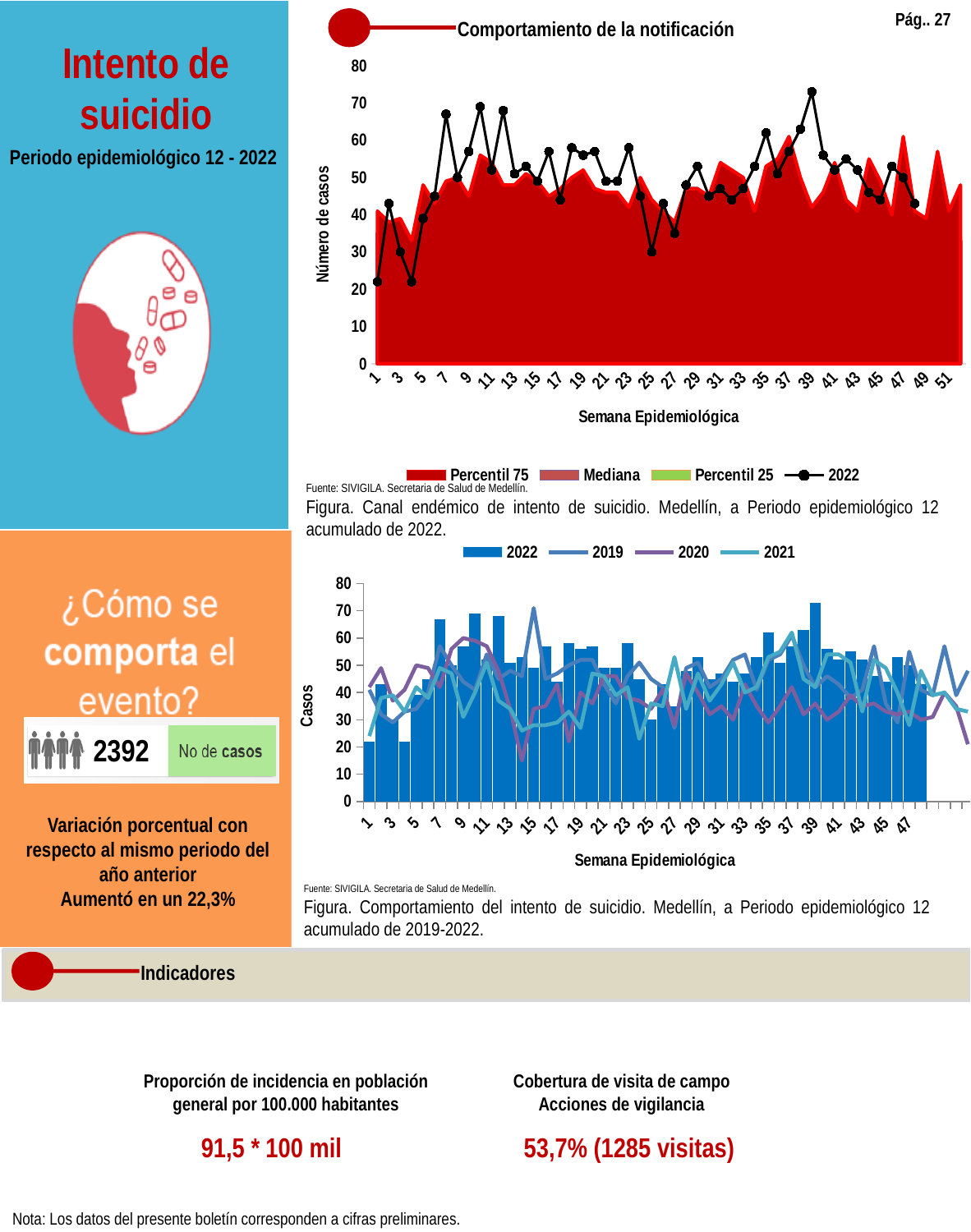
What kind of chart is used for the 2022 series in the bottom chart (Comportamiento del intento de suicidio 2019-2022)? bar chart In the bottom chart (Comportamiento del intento de suicidio 2019-2022), which series is shown as bars? 2022 In the top chart 'Comportamiento de la notificación', how many series does the legend list? 4 In the bottom chart (Comportamiento del intento de suicidio 2019-2022), which 2022 bar is taller, week 39 or week 1? week 39 In the top chart 'Comportamiento de la notificación', at which epidemiological week does the 2022 line reach its highest value? 39 In the top chart 'Comportamiento de la notificación', is the 2022 value for week 39 greater or less than 70? greater In the bottom chart (Comportamiento del intento de suicidio 2019-2022), is the 2022 bar for week 39 greater or less than 70? greater In the top chart 'Comportamiento de la notificación', is the 2022 value for week 1 greater or less than 30? less In the top chart 'Comportamiento de la notificación', which series is drawn as a black line with markers? 2022 In the bottom chart (Comportamiento del intento de suicidio 2019-2022), how many series does the legend list? 4